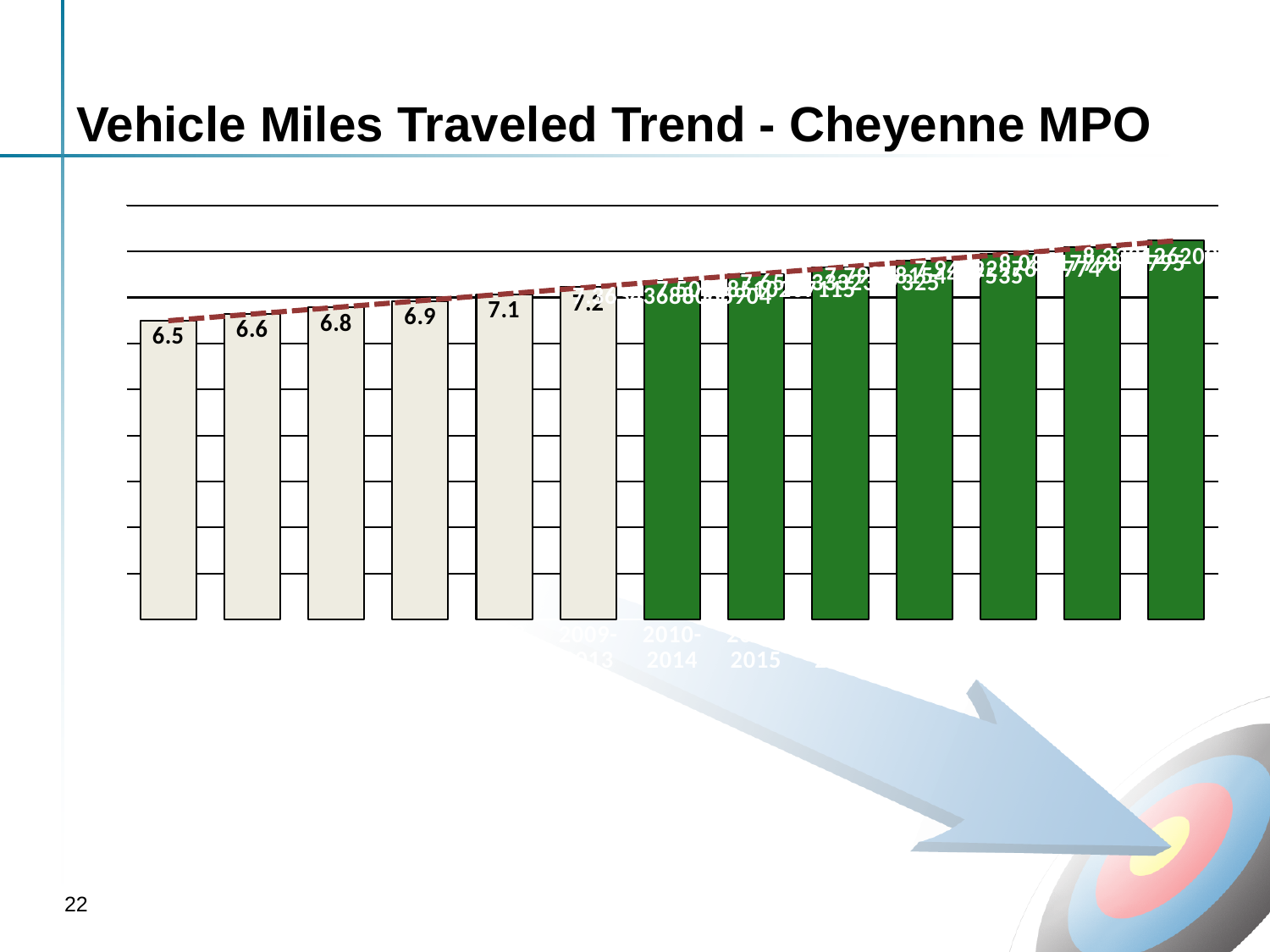
How many bars are plotted in the chart? 13 Which of the six beige bars has the lowest value? the leftmost bar (6.5) How many of the bars are colored green? 7 What is the title of the chart? Vehicle Miles Traveled Trend - Cheyenne MPO What is the value labeled on the second bar from the left? 6.6 What is the value labeled on the leftmost bar? 6.5 What is the value labeled on the fourth bar from the left? 6.9 Which is larger, the second bar from the left or the third bar from the left? the third bar (6.8) What is the value labeled on the sixth bar from the left (the last beige bar)? 7.2 Do the bar values rise or fall from left to right across the chart? rise What kind of chart is shown on the slide? bar chart What is the difference between the sixth bar from the left (7.2) and the leftmost bar (6.5)? 0.7